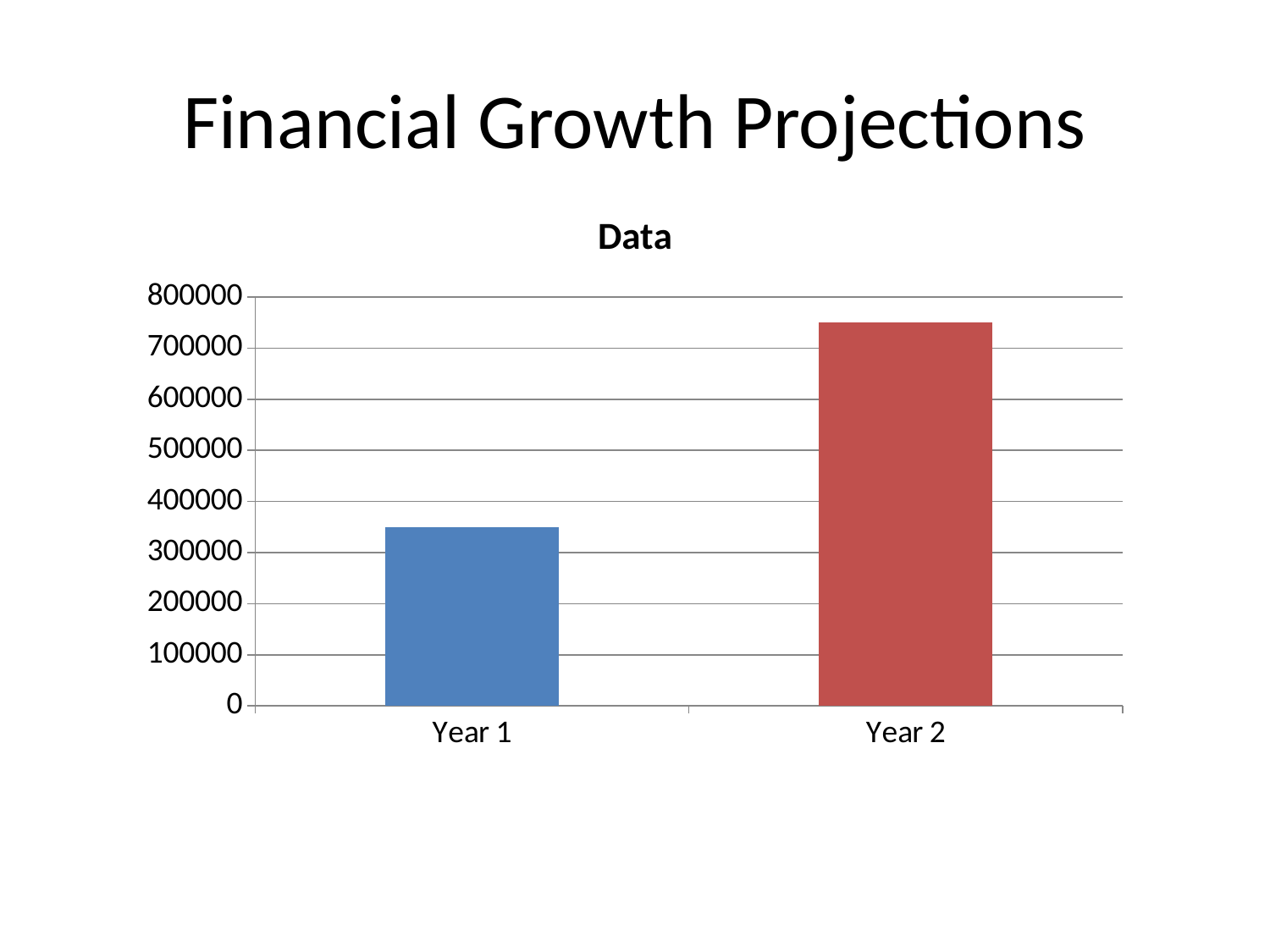
Is the value for Year 2 greater or less than 800000? less Is the value for Year 1 greater or less than 300000? greater How many categories are plotted on the x axis? 2 What kind of chart is shown on the slide? bar chart Is the value for Year 2 greater or less than 700000? greater Do the values rise or fall from Year 1 to Year 2? rise Which category has the lowest value? Year 1 Which category has the highest value? Year 2 Which is larger, the value for Year 1 or the value for Year 2? Year 2 What is the title of the chart? Data What colour is the bar for Year 2? red